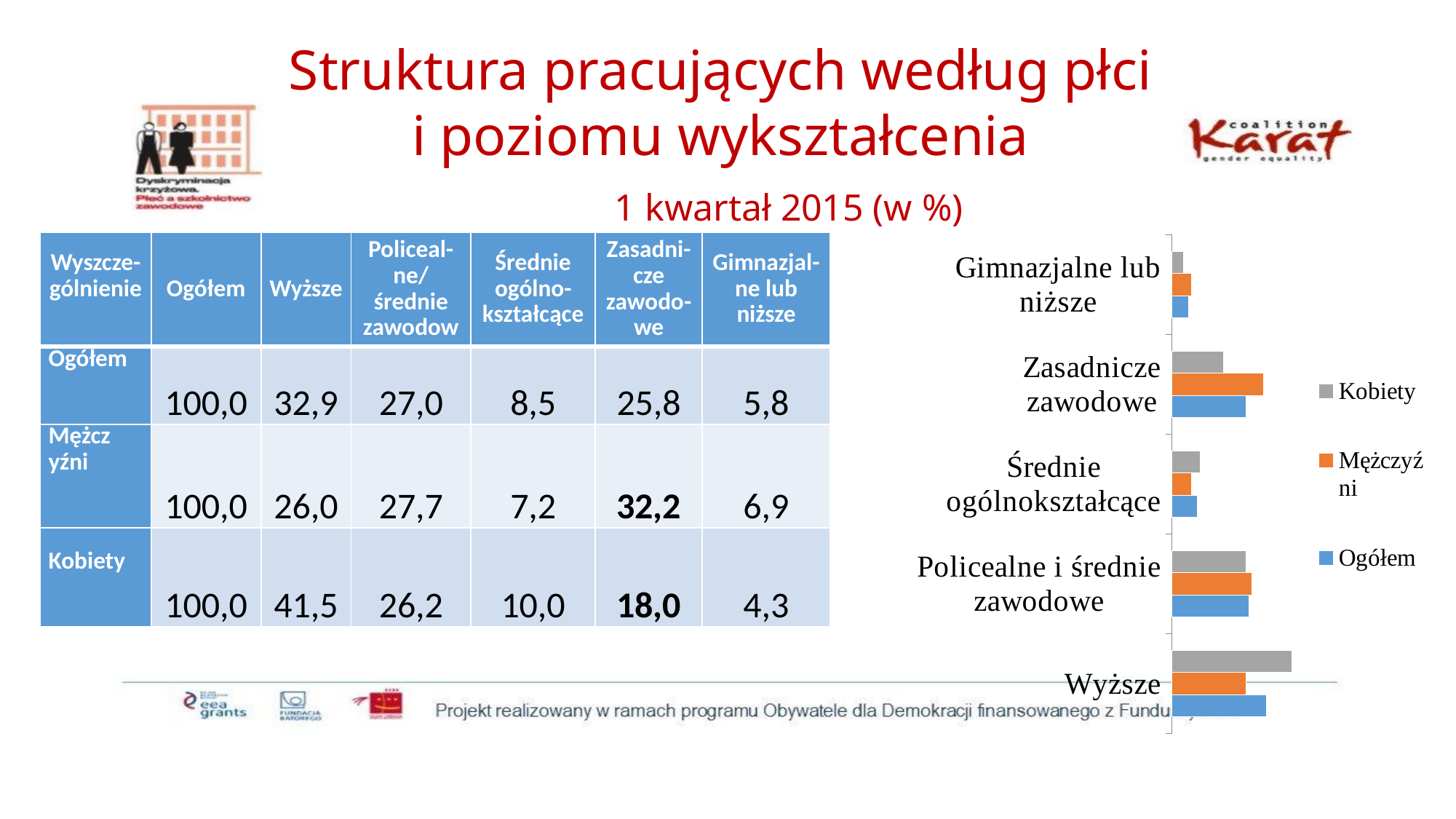
What type of chart is shown on the right side of the slide? bar chart According to the table, what is the Kobiety value for Wyższe plotted in the bar chart? 41,5 In the bar chart, for which category is the Ogółem bar the shortest? Gimnazjalne lub niższe Which series in the bar chart is shown in orange? Mężczyźni In the bar chart, for which category is the Kobiety bar the longest? Wyższe How many series does the legend of the bar chart list? 3 In the bar chart, for which category is the Mężczyźni bar the longest? Zasadnicze zawodowe Which series in the bar chart is shown in grey? Kobiety How many education-level categories does the bar chart show? 5 In the bar chart, for the Zasadnicze zawodowe category, which is larger: the Kobiety bar or the Mężczyźni bar? Mężczyźni In the bar chart, for the Wyższe category, which is larger: the Kobiety bar or the Mężczyźni bar? Kobiety Using the values in the table, what is the difference between the Kobiety and Mężczyźni values for Wyższe? 15,5